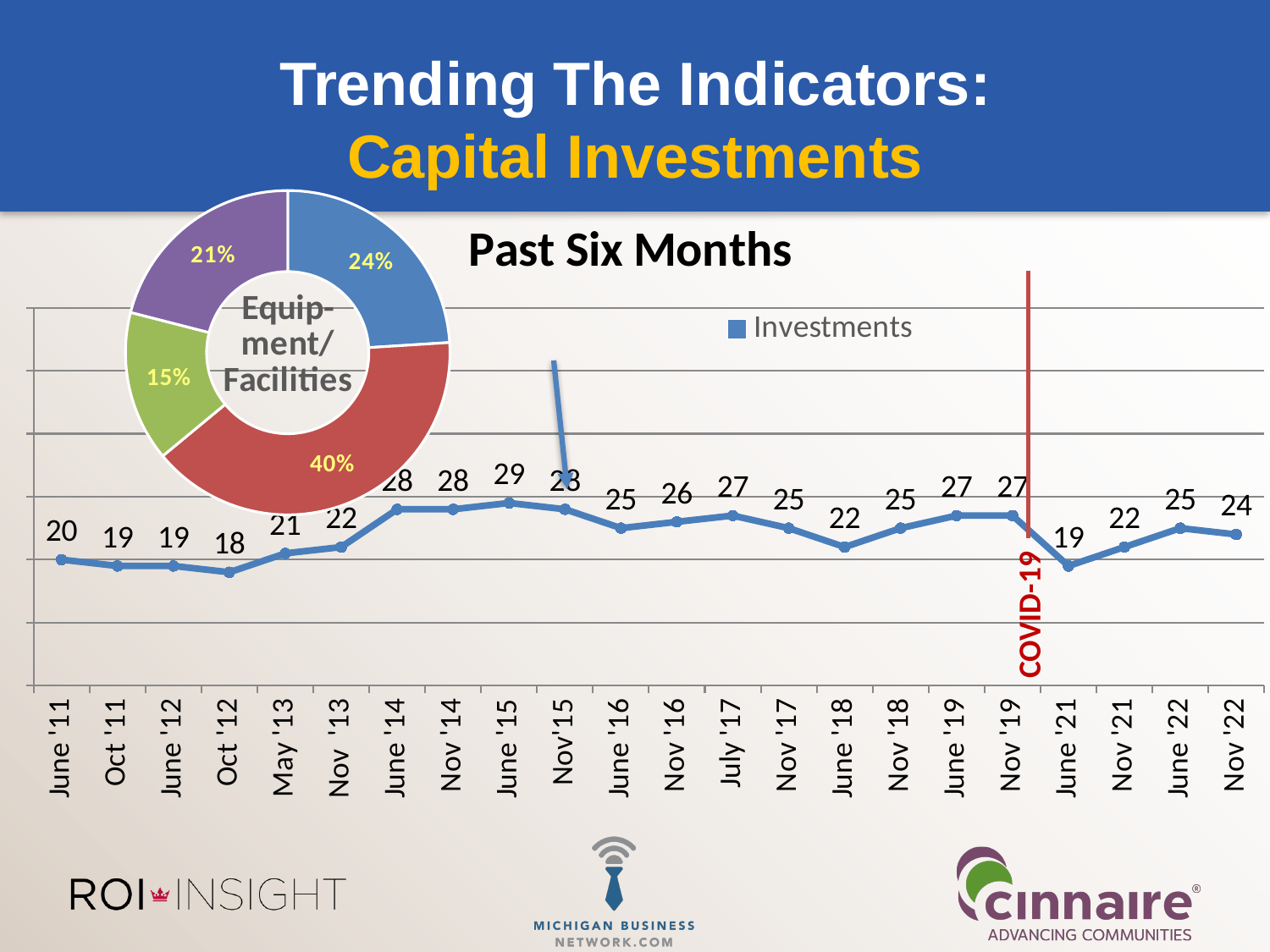
What kind of chart is the 'Past Six Months' chart? Line chart In the 'Past Six Months' line chart, which period has the highest value? June '15 In the 'Past Six Months' line chart, what is the value for Nov '22? 24 How many slices does the 'Equipment/Facilities' doughnut chart have? 4 In the 'Past Six Months' line chart, what is the value for June '21? 19 In the 'Equipment/Facilities' doughnut chart, what is the share of the largest slice? 40% In the 'Past Six Months' line chart, what is the difference between the values for June '19 and June '21? 8 What series name does the legend of the 'Past Six Months' chart show? Investments How many periods are plotted on the x axis of the 'Past Six Months' line chart? 22 In the 'Past Six Months' line chart, what is the value for June '15? 29 In the 'Past Six Months' line chart, which is larger, the value for June '14 or the value for June '18? June '14 In the 'Past Six Months' line chart, which period has the lowest value? Oct '12